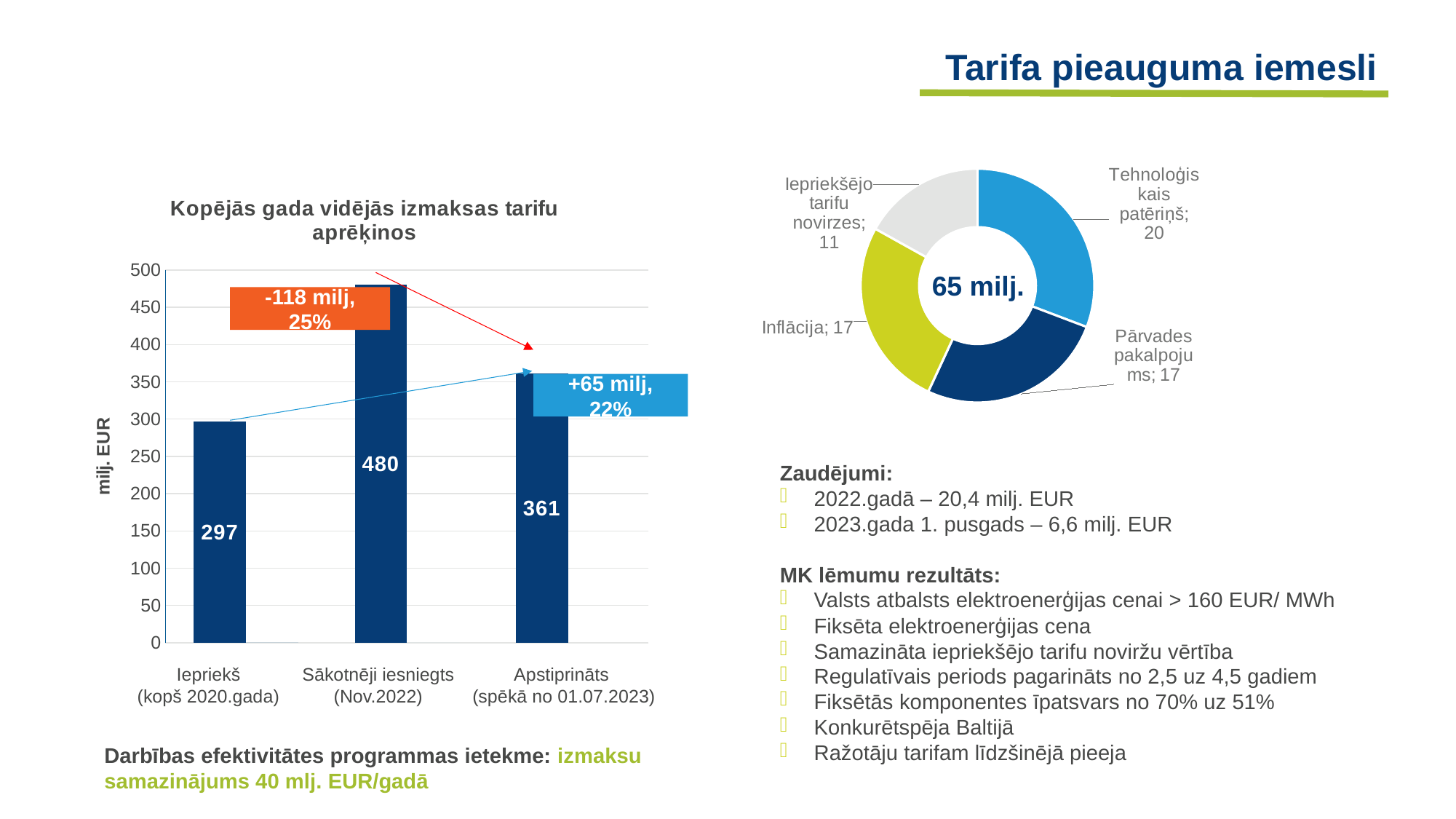
In the bar chart 'Kopējās gada vidējās izmaksas tarifu aprēķinos', what is the y-axis label? milj. EUR What kind of chart is the chart on the left side of the slide? Bar chart In the bar chart 'Kopējās gada vidējās izmaksas tarifu aprēķinos', what is the difference between 'Sākotnēji iesniegts (Nov.2022)' and 'Apstiprināts (spēkā no 01.07.2023)'? 119 In the donut chart on the right, which slice has the largest value? Tehnoloģiskais patēriņš In the bar chart 'Kopējās gada vidējās izmaksas tarifu aprēķinos', how many bars are shown? 3 In the donut chart on the right, what is the value for 'Inflācija'? 17 In the donut chart on the right, what total is shown in the centre? 65 milj. In the bar chart 'Kopējās gada vidējās izmaksas tarifu aprēķinos', what is the value for 'Apstiprināts (spēkā no 01.07.2023)'? 361 In the bar chart 'Kopējās gada vidējās izmaksas tarifu aprēķinos', what is the value for 'Sākotnēji iesniegts (Nov.2022)'? 480 In the bar chart 'Kopējās gada vidējās izmaksas tarifu aprēķinos', which category has the highest value? Sākotnēji iesniegts (Nov.2022) In the bar chart 'Kopējās gada vidējās izmaksas tarifu aprēķinos', which category has the lowest value? Iepriekš (kopš 2020.gada) In the donut chart on the right, which slice has the smallest value? Iepriekšējo tarifu novirzes